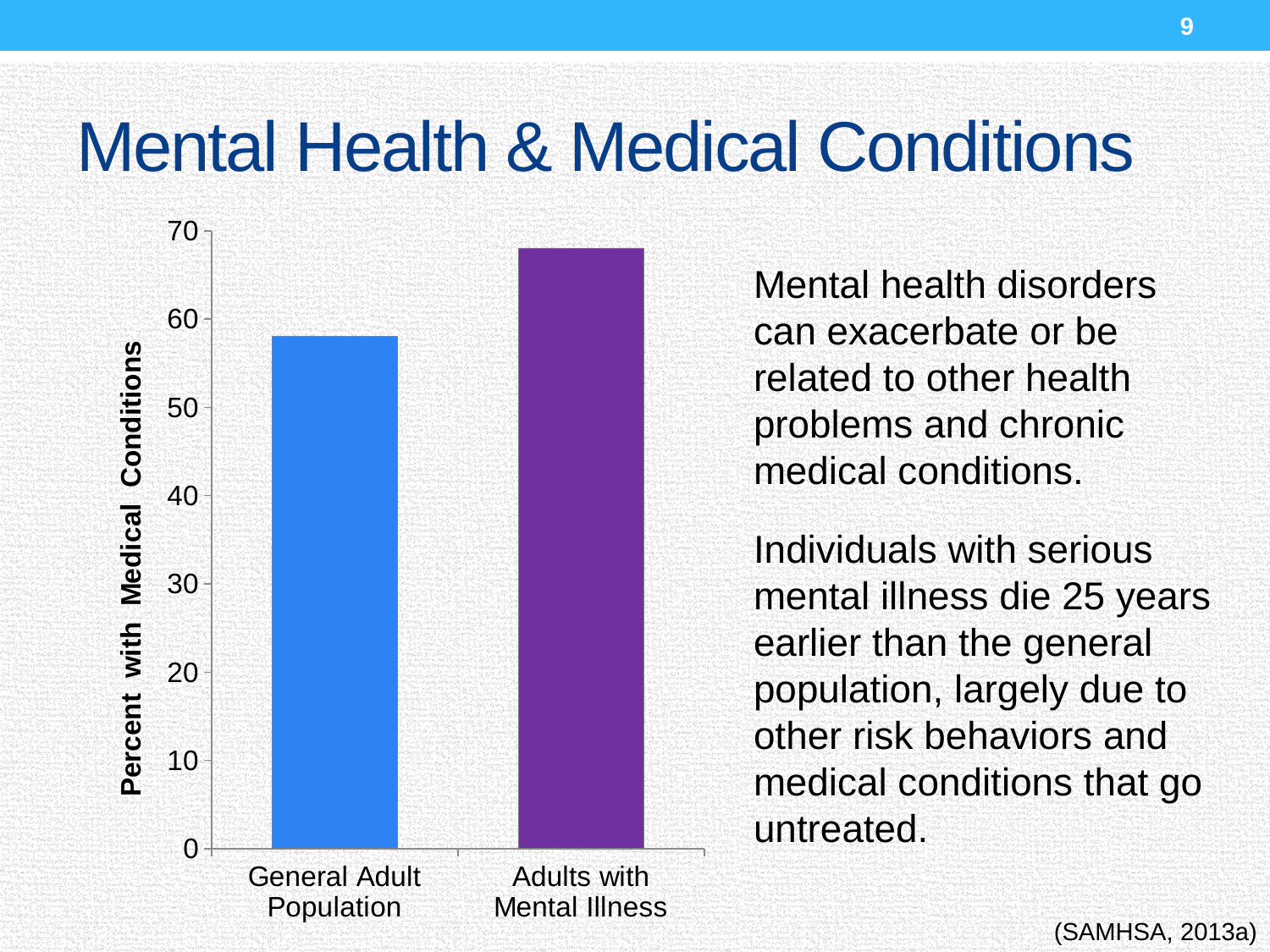
Is the value for General Adult Population greater or less than 50? greater Which category has the lowest percent with medical conditions? General Adult Population What colour is the bar for Adults with Mental Illness? purple What kind of chart is shown on the slide? bar chart What is the label on the vertical axis of the chart? Percent with Medical Conditions Which is larger: the value for General Adult Population or the value for Adults with Mental Illness? Adults with Mental Illness How many categories are shown on the x axis of the chart? 2 Which category has the highest percent with medical conditions? Adults with Mental Illness Is the value for Adults with Mental Illness greater or less than 70? less Is the value for Adults with Mental Illness greater or less than 60? greater